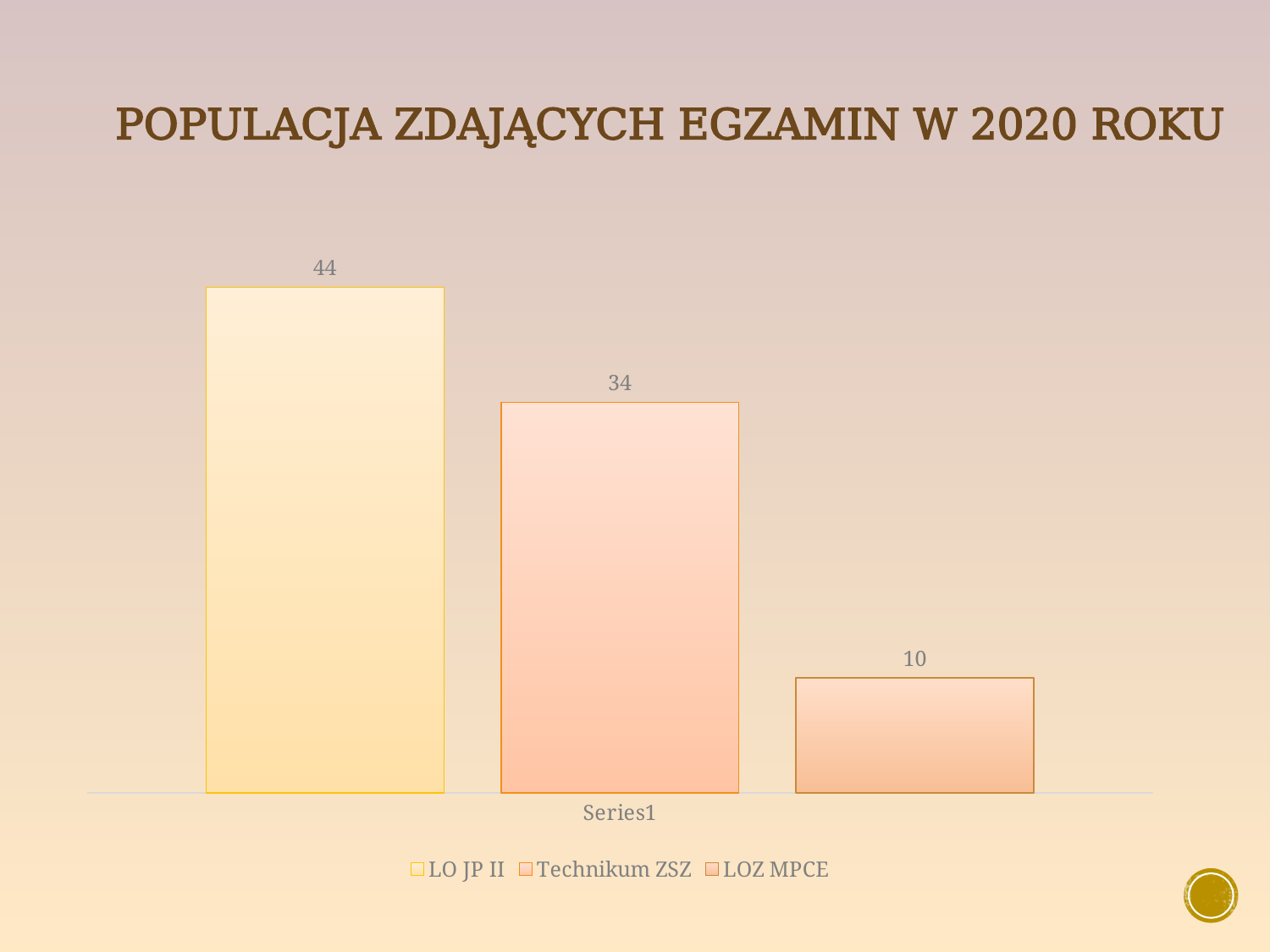
What is the value for LOZ MPCE? 10 What is the value for Technikum ZSZ? 34 What is the difference between the values for Technikum ZSZ and LOZ MPCE? 24 What is the difference between the values for LO JP II and Technikum ZSZ? 10 What kind of chart is shown on the slide? bar chart How many series does the legend list? 3 What is the title of the chart? POPULACJA ZDAJĄCYCH EGZAMIN W 2020 ROKU What is the category label shown on the x axis? Series1 Which series has the lowest value? LOZ MPCE What is the value for LO JP II? 44 Which series has the highest value? LO JP II Which is larger, the value for Technikum ZSZ or the value for LOZ MPCE? Technikum ZSZ